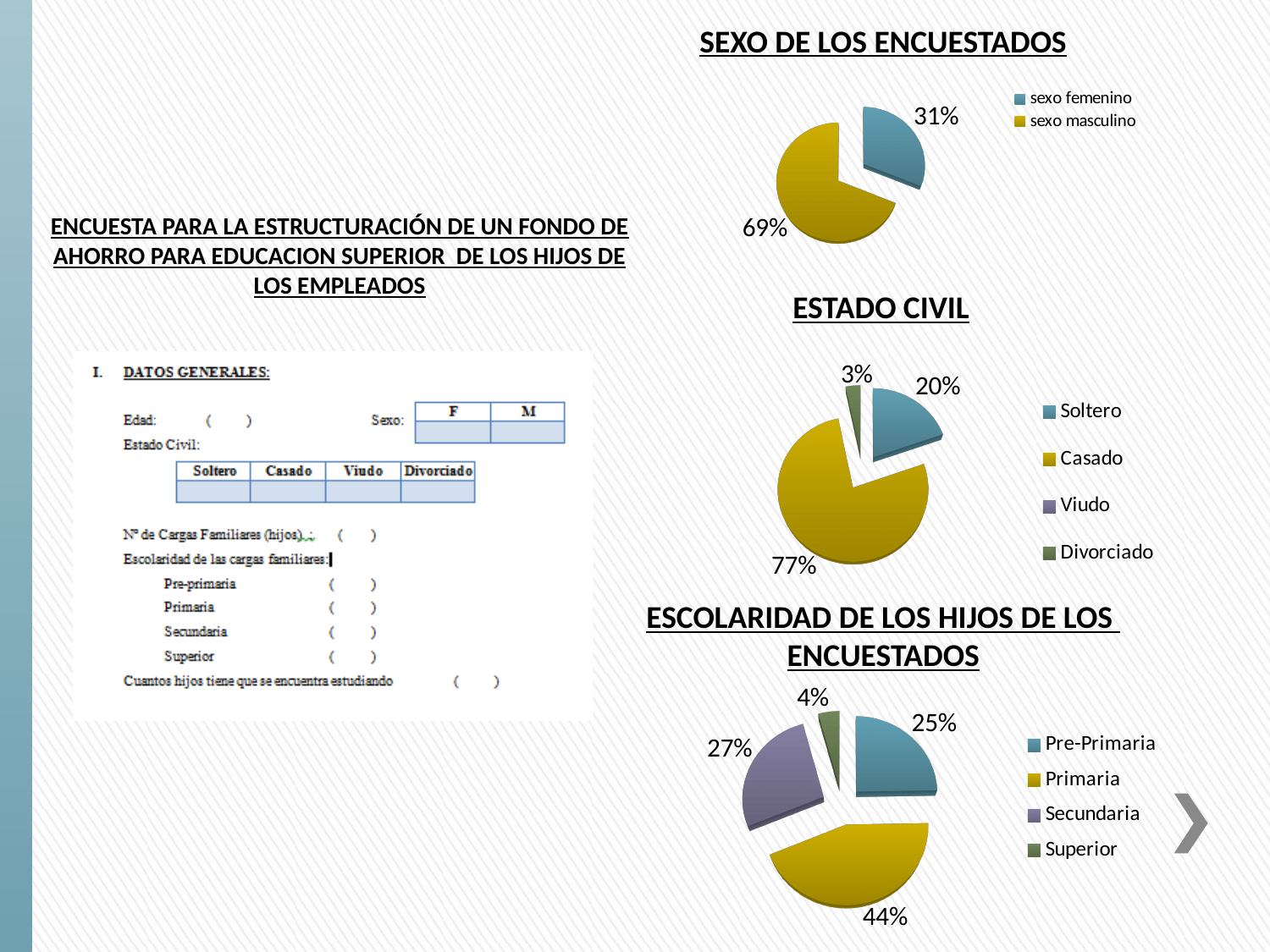
In the 'ESTADO CIVIL' chart, which category has the largest share? Casado In the 'ESCOLARIDAD DE LOS HIJOS DE LOS ENCUESTADOS' chart, which is larger, Pre-Primaria or Secundaria? Secundaria In the 'SEXO DE LOS ENCUESTADOS' chart, what percentage is sexo masculino? 69% In the 'ESCOLARIDAD DE LOS HIJOS DE LOS ENCUESTADOS' chart, what percentage is Secundaria? 27% What kind of chart is the 'ESTADO CIVIL' chart? Pie chart In the 'ESCOLARIDAD DE LOS HIJOS DE LOS ENCUESTADOS' chart, what percentage is Primaria? 44% In the 'SEXO DE LOS ENCUESTADOS' chart, what percentage is sexo femenino? 31% In the 'ESCOLARIDAD DE LOS HIJOS DE LOS ENCUESTADOS' chart, which category has the smallest share? Superior In the 'ESTADO CIVIL' chart, what percentage is Casado? 77% In the 'ESTADO CIVIL' chart, what percentage is Soltero? 20% In the 'SEXO DE LOS ENCUESTADOS' chart, what is the difference between sexo masculino and sexo femenino? 38% How many entries does the legend of the 'ESTADO CIVIL' chart list? 4